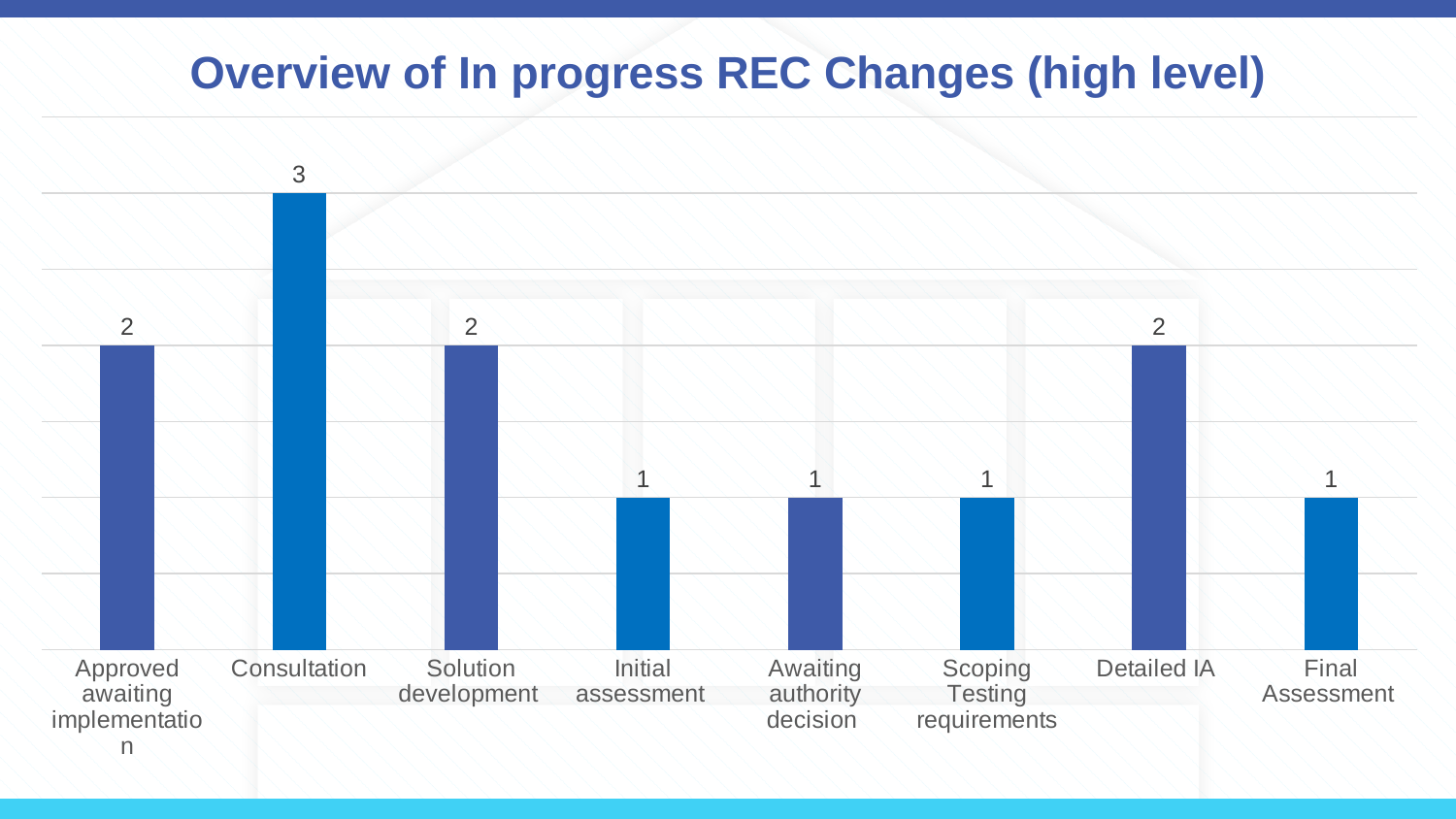
What is the value for Final Assessment? 1 What is the difference between the values for Solution development and Awaiting authority decision? 1 What is the value for Detailed IA? 2 How many categories are shown in the chart? 8 What is the value for Scoping Testing requirements? 1 What is the difference between the values for Consultation and Initial assessment? 2 Which is larger, the value for Consultation or the value for Detailed IA? Consultation Which category has the highest value? Consultation What is the value for Approved awaiting implementation? 2 What is the title of the slide? Overview of In progress REC Changes (high level) What kind of chart is shown on the slide? Bar chart What is the value for Consultation? 3